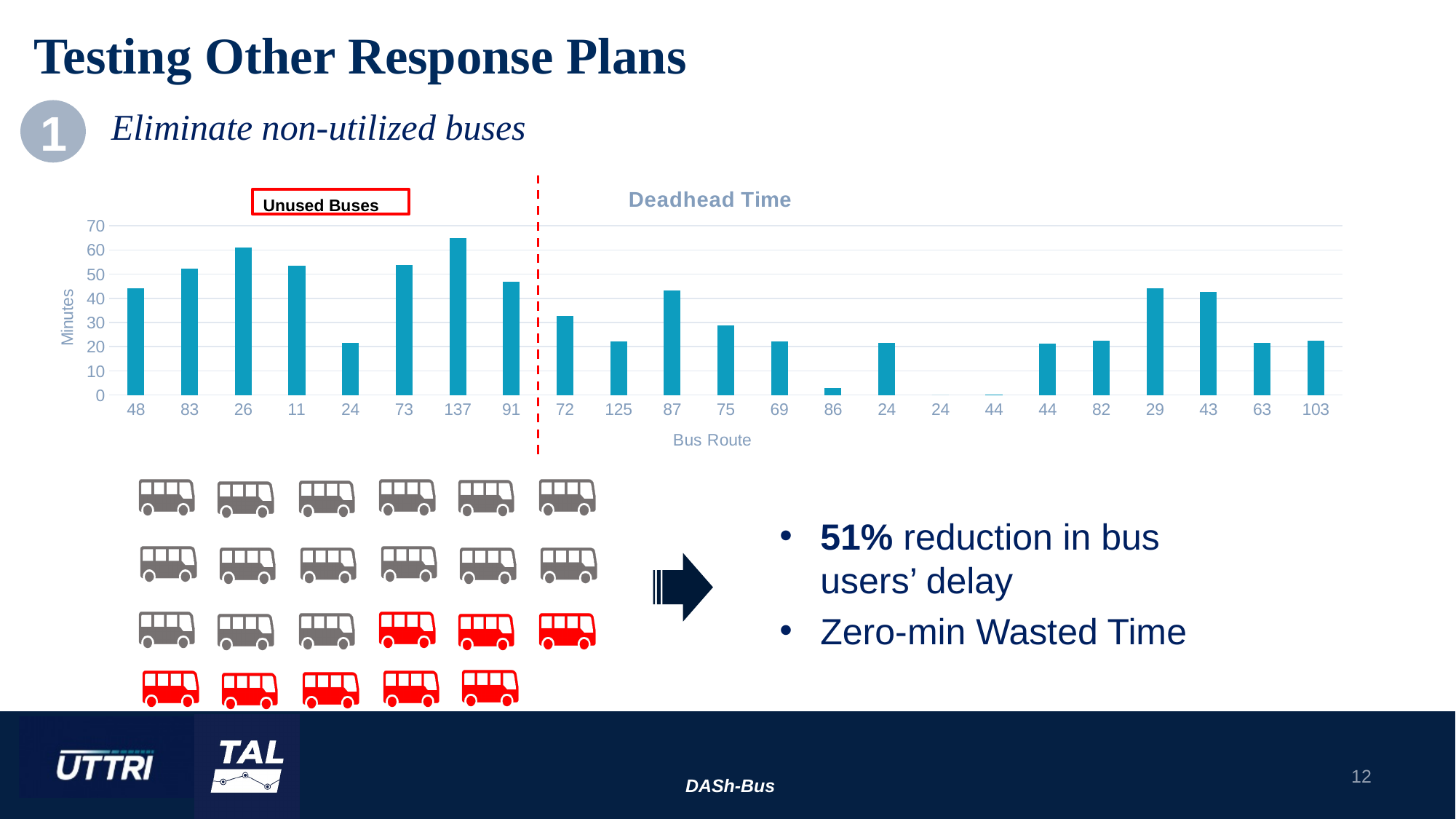
Is the value for bus route 137 greater or less than 60? greater How many bus routes are shown along the x axis of the chart? 23 Which has a higher deadhead time, bus route 26 or bus route 11? 26 Which has a higher deadhead time, bus route 83 or bus route 72? 83 What is the title of the chart? Deadhead Time Is the value for bus route 86 greater or less than 10? less Which bus route has the highest deadhead time? 137 Is the value for bus route 103 greater or less than 30? less What kind of chart is shown on the slide? bar chart What is the label of the y axis of the chart? Minutes